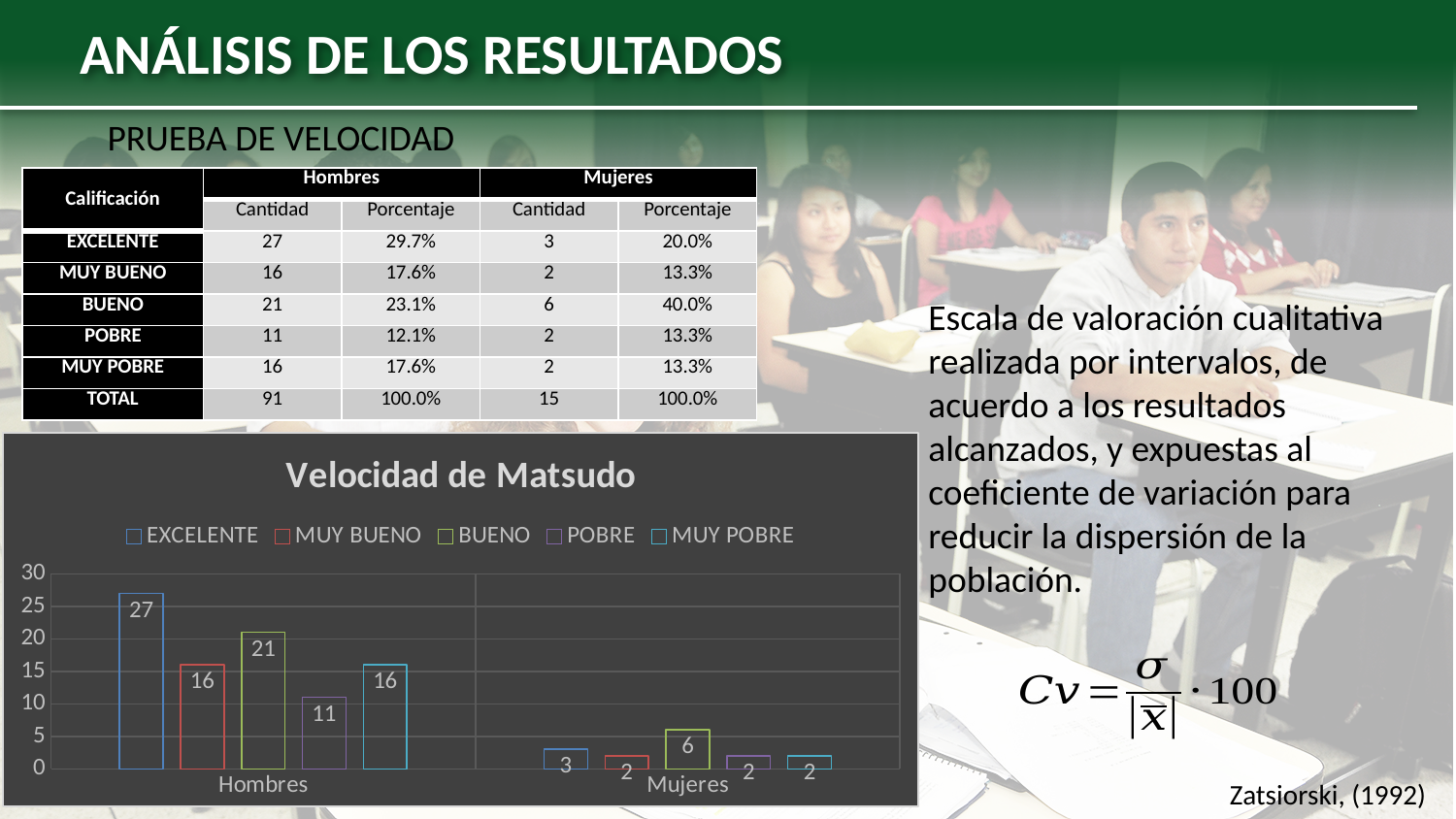
In the 'Velocidad de Matsudo' chart, which series has the highest value for Hombres? EXCELENTE How many series does the legend of the 'Velocidad de Matsudo' chart list? 5 In the 'Velocidad de Matsudo' chart, what is the value of BUENO for Mujeres? 6 In the 'Velocidad de Matsudo' chart, which series has the lowest value for Hombres? POBRE In the 'Velocidad de Matsudo' chart, which series has the highest value for Mujeres? BUENO In the 'Velocidad de Matsudo' chart, what is the value of EXCELENTE for Hombres? 27 In the 'Velocidad de Matsudo' chart, what is the value of POBRE for Hombres? 11 In the 'Velocidad de Matsudo' chart, what is the difference between EXCELENTE and BUENO for Hombres? 6 How many categories are shown on the x axis of the 'Velocidad de Matsudo' chart? 2 In the 'Velocidad de Matsudo' chart, what is the title of the chart? Velocidad de Matsudo In the 'Velocidad de Matsudo' chart, which is larger for Hombres: MUY BUENO or BUENO? BUENO What type of chart is 'Velocidad de Matsudo'? bar chart